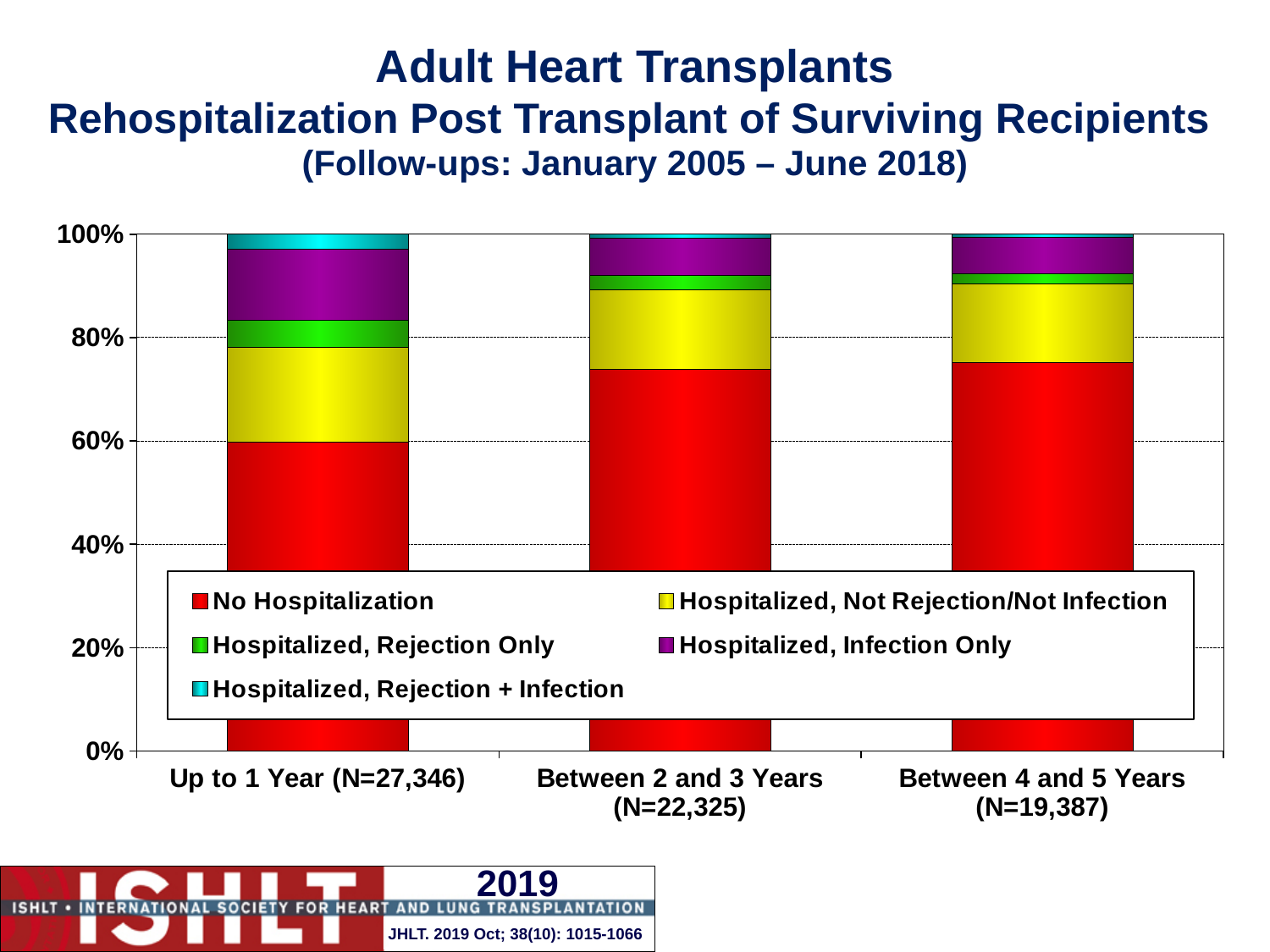
Which colour represents No Hospitalization in the legend? Red How many series does the legend list? 5 What does each stacked bar total? 100% What kind of chart is shown on the slide? Stacked bar chart How many follow-up categories are shown on the x axis? 3 Is the No Hospitalization share for Up to 1 Year greater or less than 40%? greater Which follow-up category has the largest Hospitalized, Infection Only segment? Up to 1 Year (N=27,346) Which has the larger No Hospitalization share: Up to 1 Year or Between 2 and 3 Years? Between 2 and 3 Years Is the No Hospitalization share for Between 4 and 5 Years greater or less than 80%? less Is the No Hospitalization share for Between 2 and 3 Years greater or less than 60%? greater Does the No Hospitalization share rise or fall from Up to 1 Year to Between 4 and 5 Years? rise Which follow-up category has the largest Hospitalized, Rejection + Infection segment? Up to 1 Year (N=27,346)